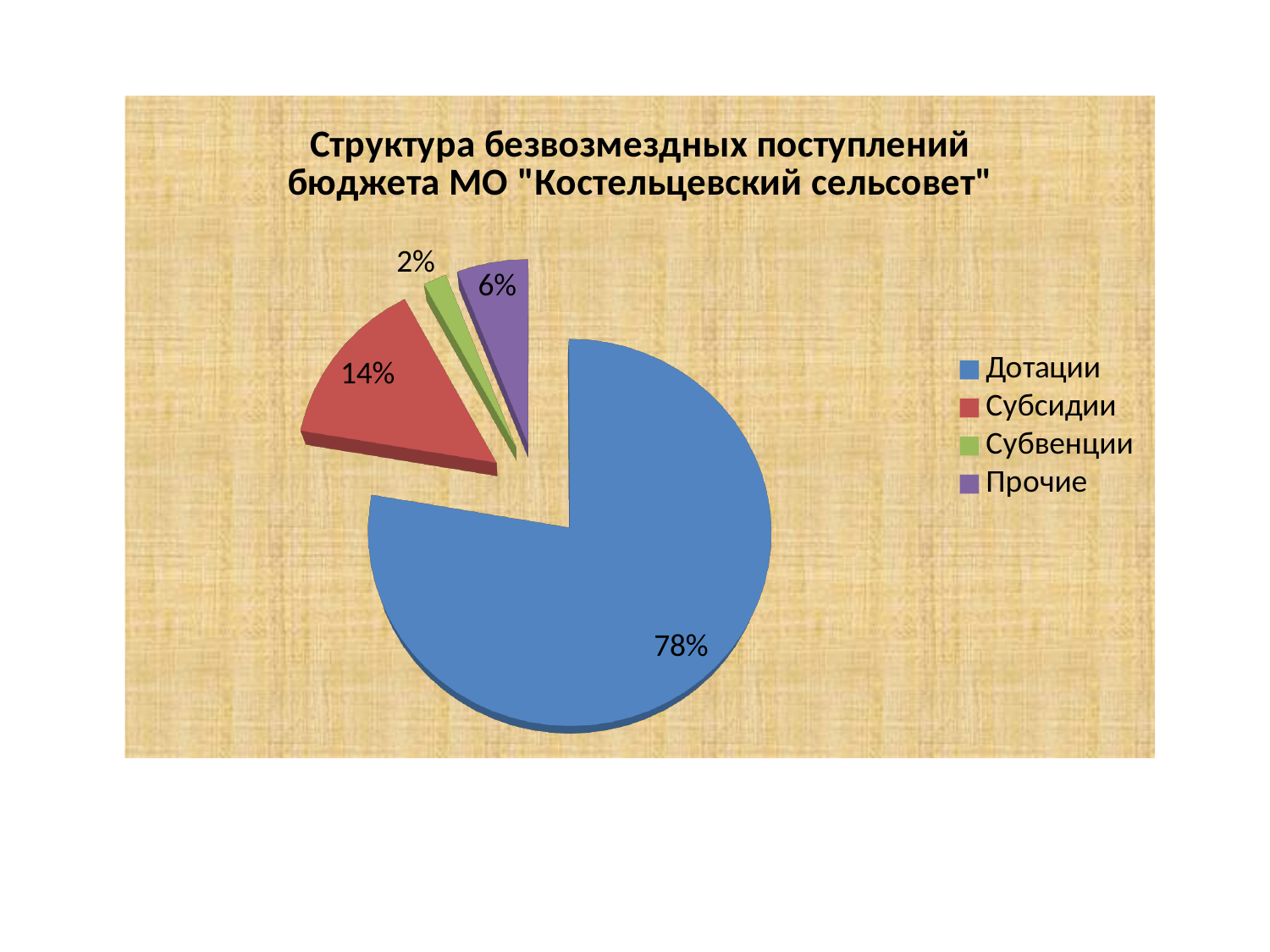
Which is larger, the share for Субсидии or the share for Прочие? Субсидии What share of the pie does Субсидии have? 14% What is the difference in percentage points between Прочие and Субвенции? 4 What share of the pie does Прочие have? 6% What share of the pie does Дотации have? 78% What colour is the slice for Субвенции? Green What is the difference in percentage points between Дотации and Субсидии? 64 How many categories does the pie chart show? 4 Which category has the smallest slice of the pie? Субвенции What kind of chart is shown on the slide? Pie chart Which category has the largest slice of the pie? Дотации